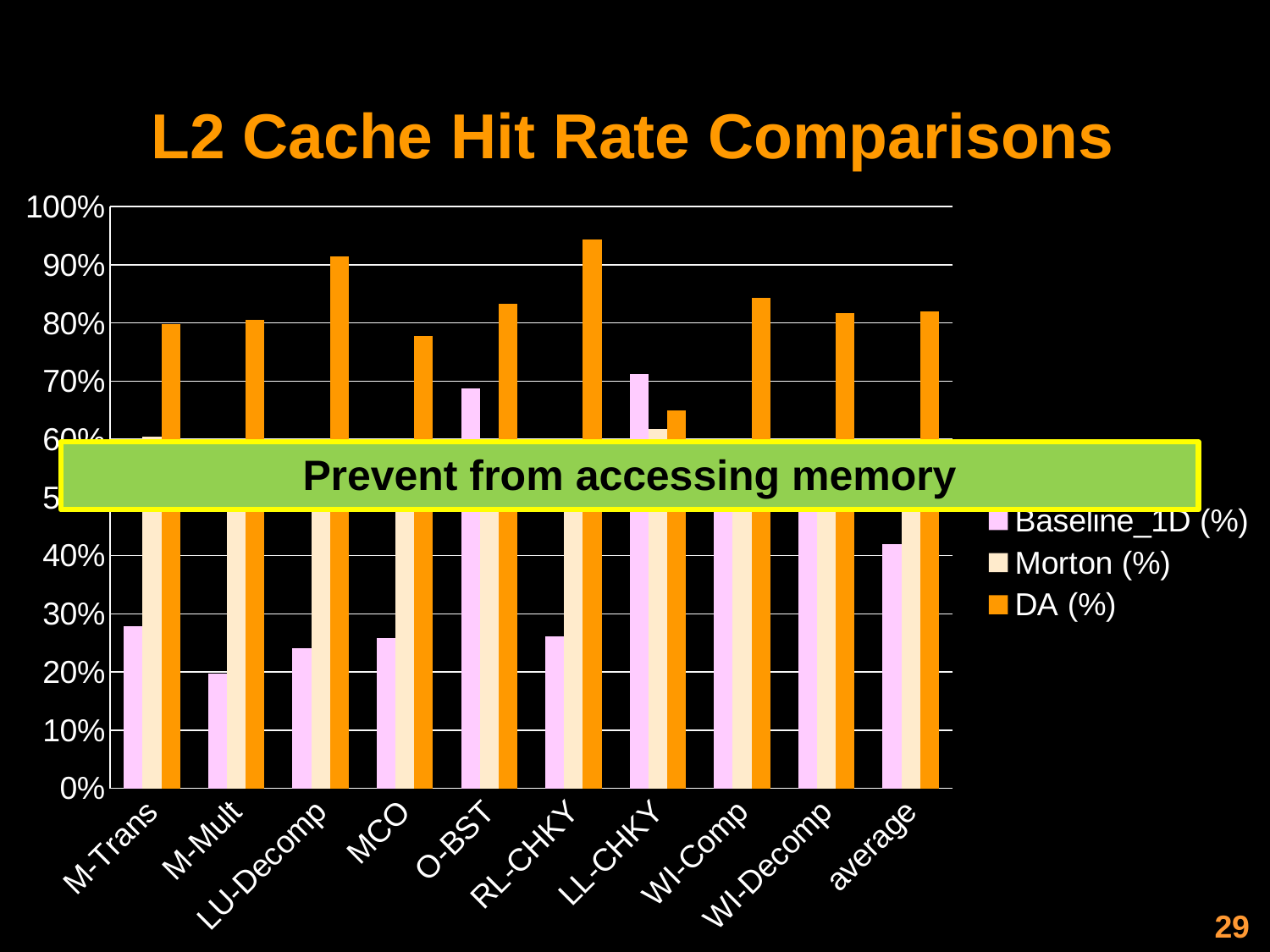
For M-Trans, which is larger: the DA (%) value or the Baseline_1D (%) value? DA (%) How many series does the legend list? 3 Is the DA (%) value for LL-CHKY greater or less than 70%? less For which category is the DA (%) value lowest? LL-CHKY What kind of chart is shown on the slide? bar chart Is the DA (%) value for RL-CHKY greater or less than 90%? greater Is the Baseline_1D (%) value for M-Trans greater or less than 30%? less What is the title of the chart? L2 Cache Hit Rate Comparisons How many categories are shown on the x axis? 10 For which category is the Baseline_1D (%) value lowest? M-Mult Which series is drawn in orange? DA (%) For which category is the DA (%) value highest? RL-CHKY